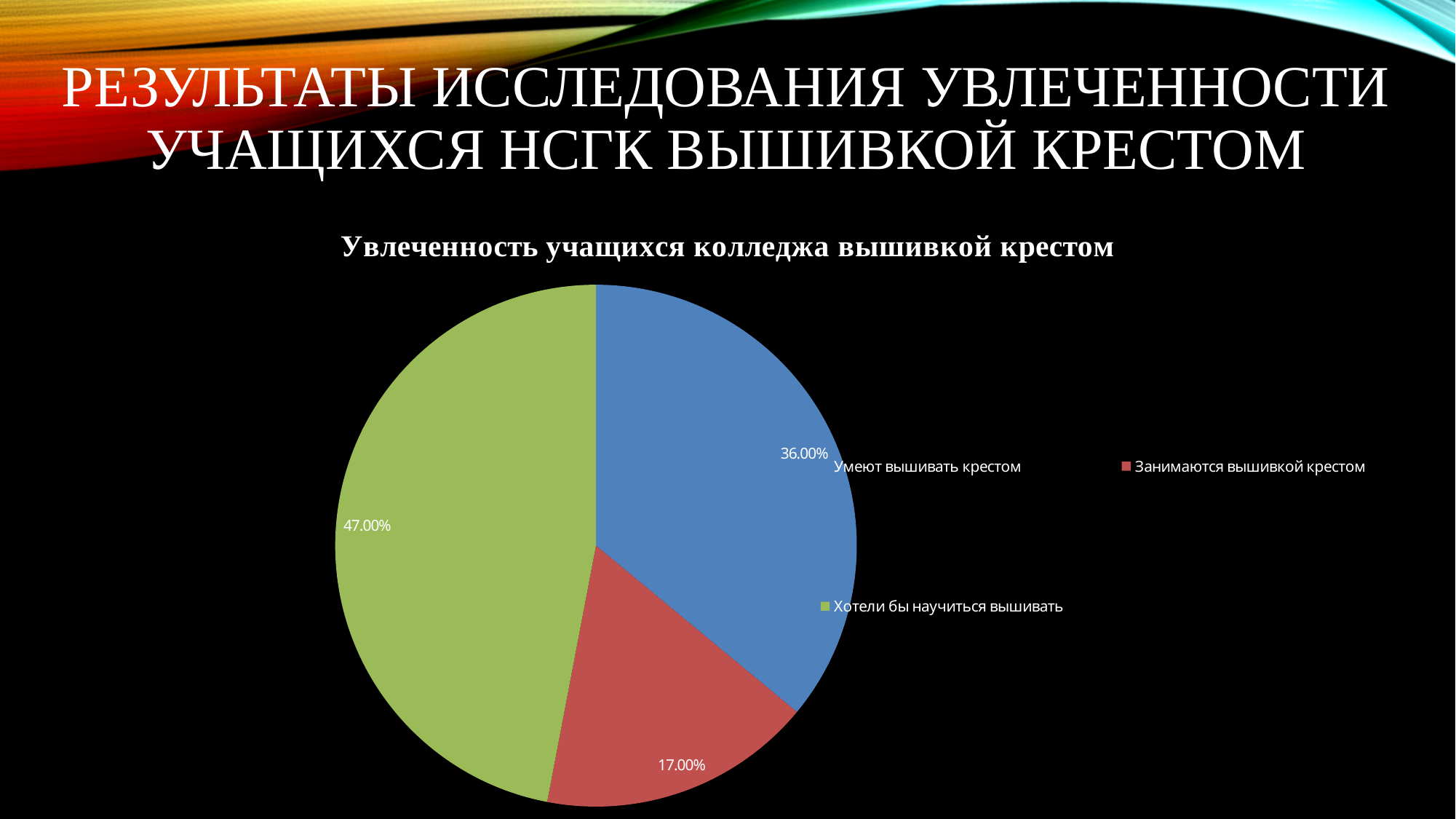
How many slices does the pie chart have? 3 What percentage is shown for "Хотели бы научиться вышивать"? 47.00% What is the title of the chart? Увлеченность учащихся колледжа вышивкой крестом What percentage is shown for "Занимаются вышивкой крестом"? 17.00% What is the difference between the shares for "Хотели бы научиться вышивать" and "Умеют вышивать крестом"? 11.00% What is the difference between the shares for "Умеют вышивать крестом" and "Занимаются вышивкой крестом"? 19.00% Which category has the largest share of the pie? Хотели бы научиться вышивать Which is larger: the share for "Умеют вышивать крестом" or for "Занимаются вышивкой крестом"? Умеют вышивать крестом What percentage is shown for "Умеют вышивать крестом"? 36.00% What colour is the slice for "Занимаются вышивкой крестом"? Red Which category has the smallest share of the pie? Занимаются вышивкой крестом What type of chart is shown on the slide? Pie chart